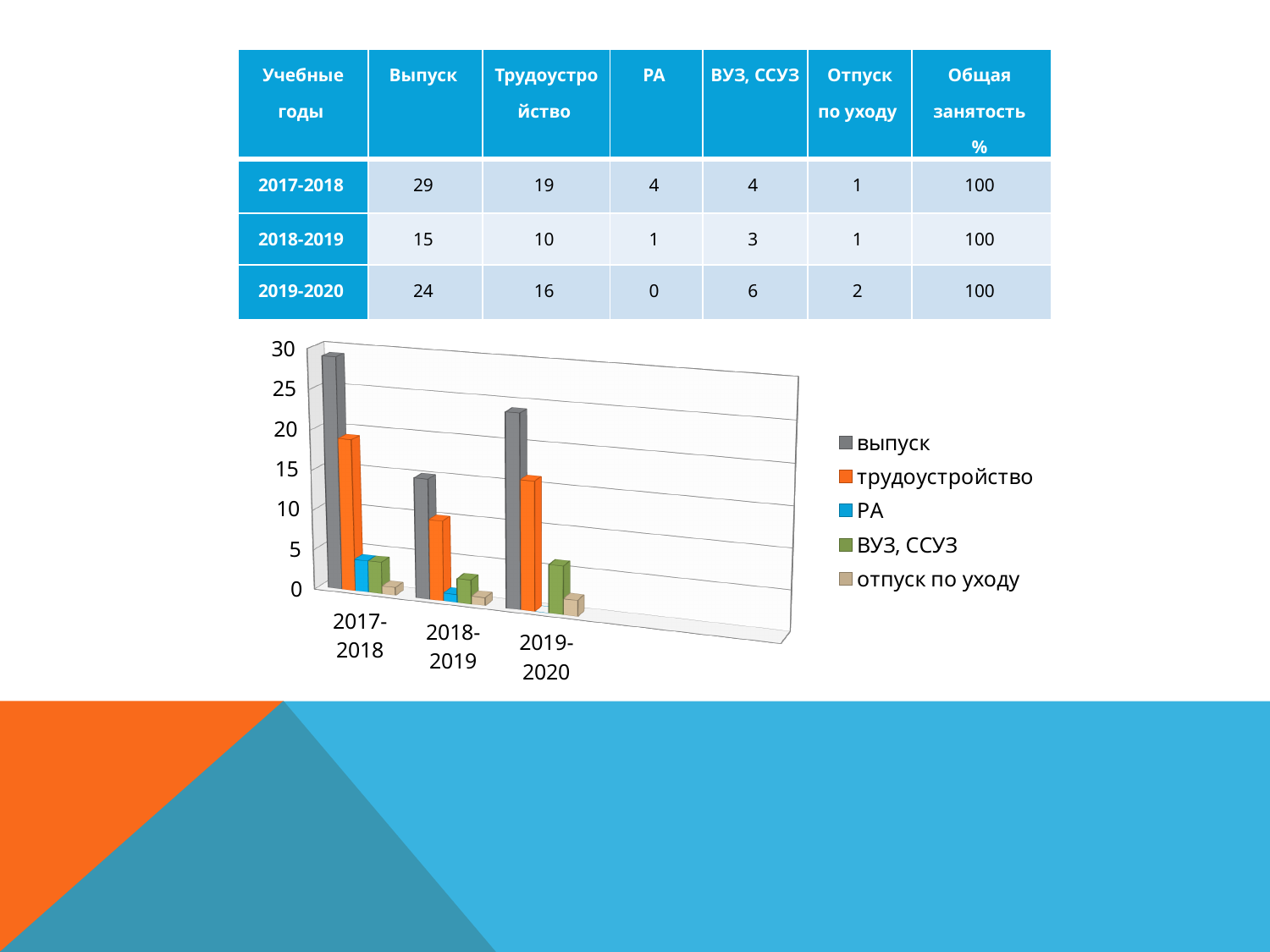
Which academic year has the lowest value for выпуск? 2018-2019 What colour represents трудоустройство in the chart legend? orange According to the table on the slide, what is the difference between Выпуск and Трудоустройство for 2017-2018? 10 How does the value for выпуск change from 2017-2018 to 2018-2019 to 2019-2020? falls, then rises What kind of chart is shown on the slide? bar chart Which is larger: трудоустройство in 2017-2018 or трудоустройство in 2019-2020? 2017-2018 Which academic year has the highest value for выпуск? 2017-2018 How many academic-year categories are shown on the chart's x axis? 3 How many series does the chart legend list? 5 Is the value for выпуск in 2017-2018 greater or less than 25? greater According to the table on the slide, what is the value of Выпуск for 2019-2020? 24 Is the value for трудоустройство in 2018-2019 greater or less than 15? less